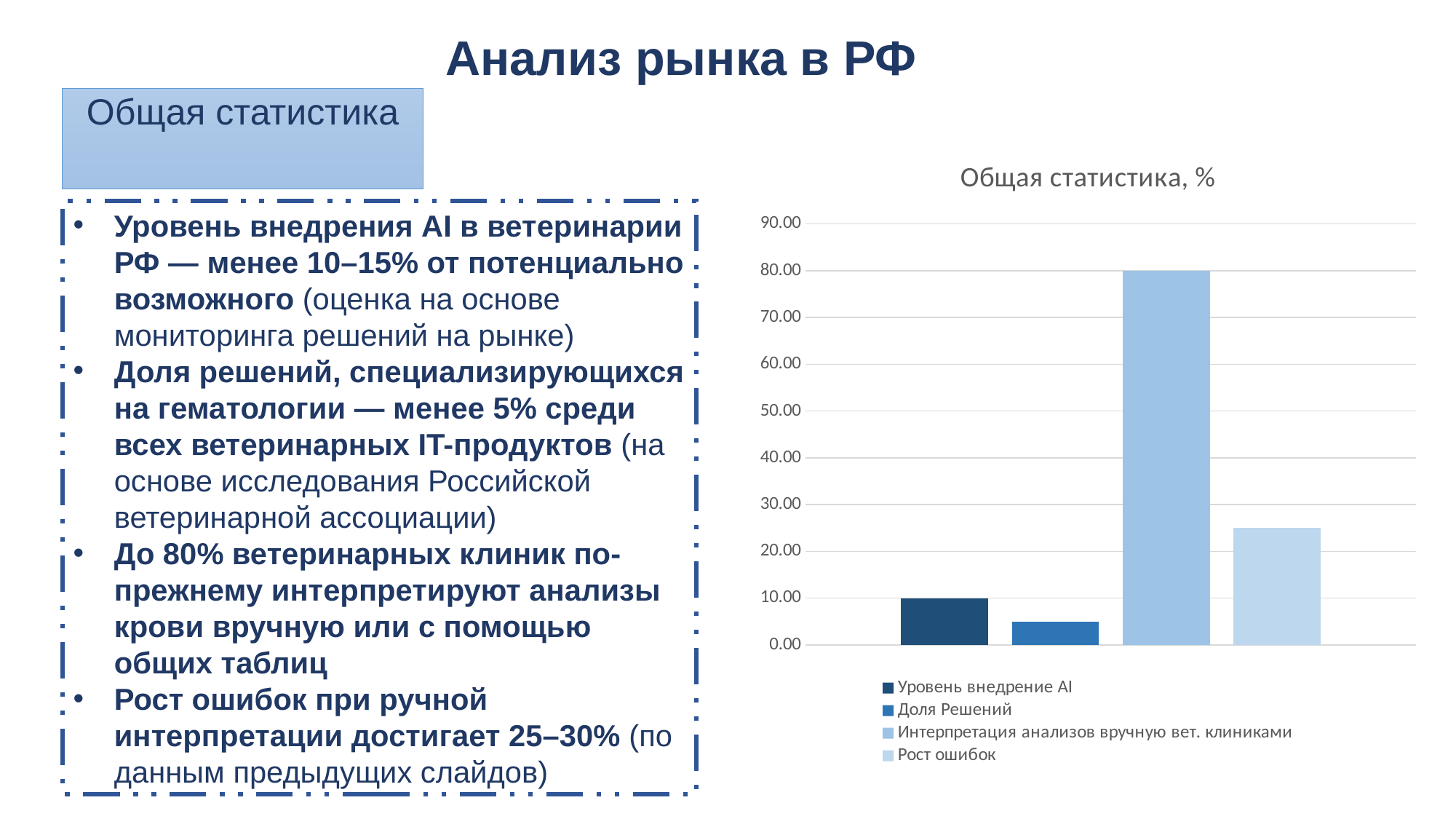
How many bars are plotted in the chart? 4 What is the title of the chart? Общая статистика, % What is the difference between the values for Интерпретация анализов вручную вет. клиниками and Уровень внедрение AI? 70.00 Which is larger, the value for Рост ошибок or the value for Уровень внедрение AI? Рост ошибок What type of chart is shown on the slide? bar chart Which series has the highest value in the chart? Интерпретация анализов вручную вет. клиниками Is the value for Рост ошибок greater or less than 20.00? greater Is the value for Доля Решений greater or less than 10.00? less How many series does the chart legend list? 4 What is the value for Уровень внедрение AI? 10.00 Which series has the lowest value in the chart? Доля Решений What is the value for Интерпретация анализов вручную вет. клиниками? 80.00